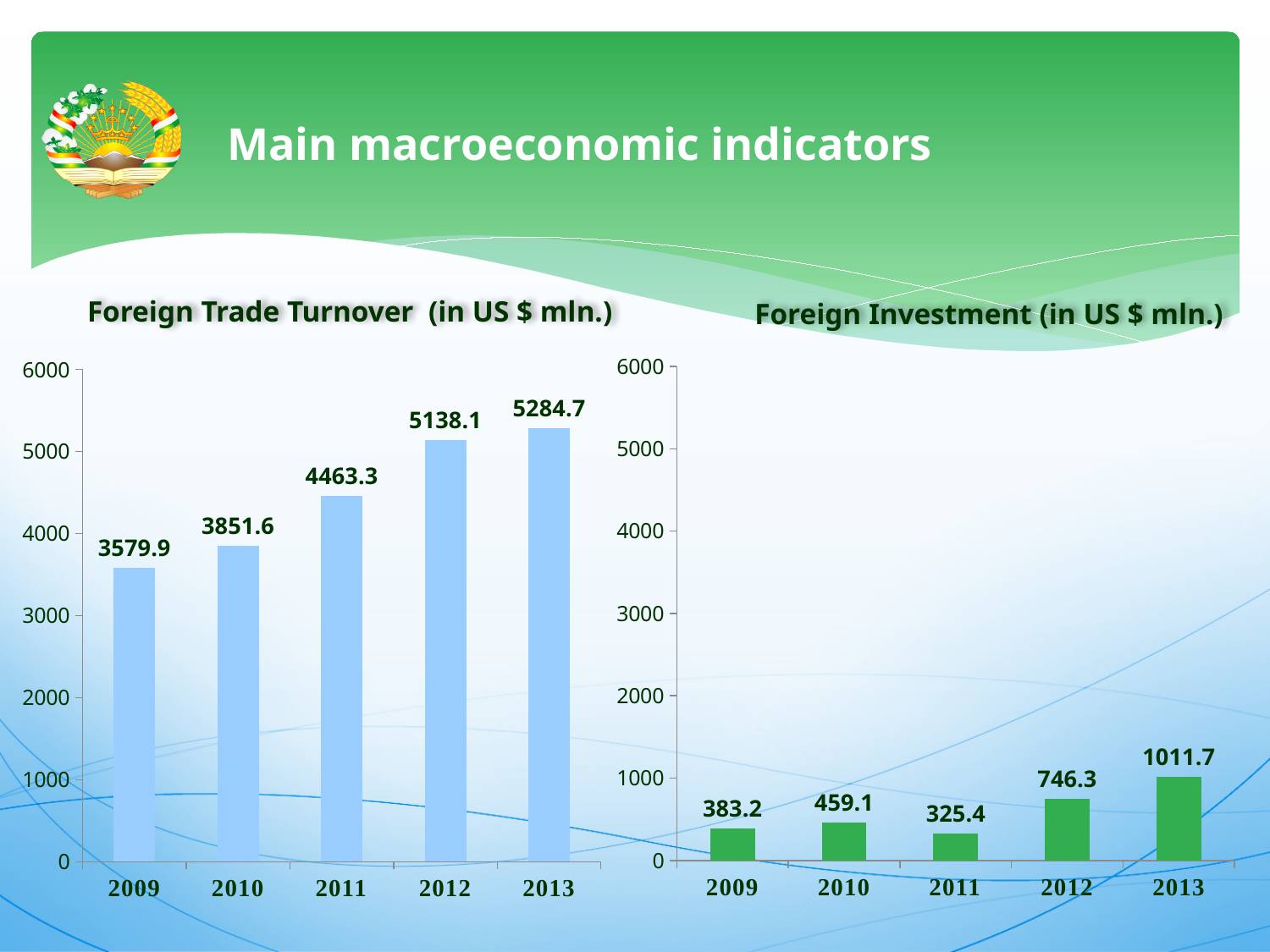
How many years are shown in the Foreign Investment chart? 5 In the Foreign Trade Turnover chart, do the values rise or fall from 2009 to 2013? rise In the Foreign Investment chart, which is larger, the value for 2010 or the value for 2011? 2010 In the Foreign Trade Turnover chart, what is the value for 2011? 4463.3 In the Foreign Investment chart, what is the difference between the 2013 and 2011 values? 686.3 In the Foreign Investment chart, which year has the lowest value? 2011 In the Foreign Trade Turnover chart, what is the difference between the 2013 and 2009 values? 1704.8 What kind of chart is the Foreign Trade Turnover chart? bar chart What is the title of the chart on the right side of the slide? Foreign Investment (in US $ mln.) In the Foreign Investment chart, what is the value for 2012? 746.3 In the Foreign Trade Turnover chart, is the value for 2012 greater or less than 5000? greater In the Foreign Trade Turnover chart, which year has the highest value? 2013